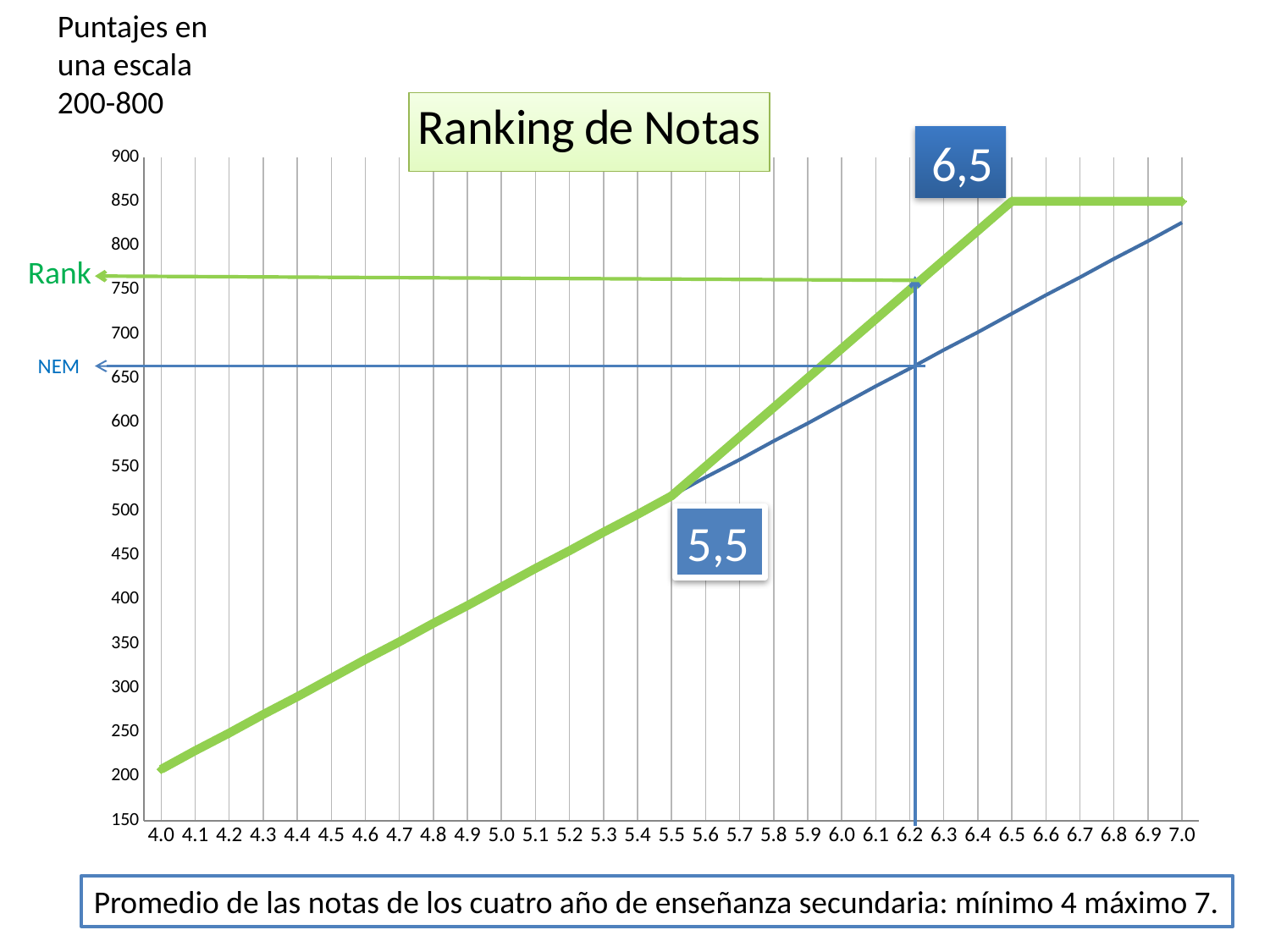
What are the two grade values highlighted in the blue boxes on the chart? 5,5 and 6,5 What is the title of the chart? Ranking de Notas How many lines are plotted on the chart? 2 Is the value of the Rank line at 6.2 greater or less than 700? greater At 6.2, which line has the higher value, Rank or NEM? Rank How many tick labels are shown on the x axis of the chart? 31 Is the value of the NEM line at 6.2 greater or less than 700? less Does the Rank line rise or fall as the x axis goes from 4.0 to 6.5? rise Is the value of the Rank line at 5.5 greater or less than 550? less What kind of chart is shown on the slide? line chart What value does the Rank line reach at 7.0? 850